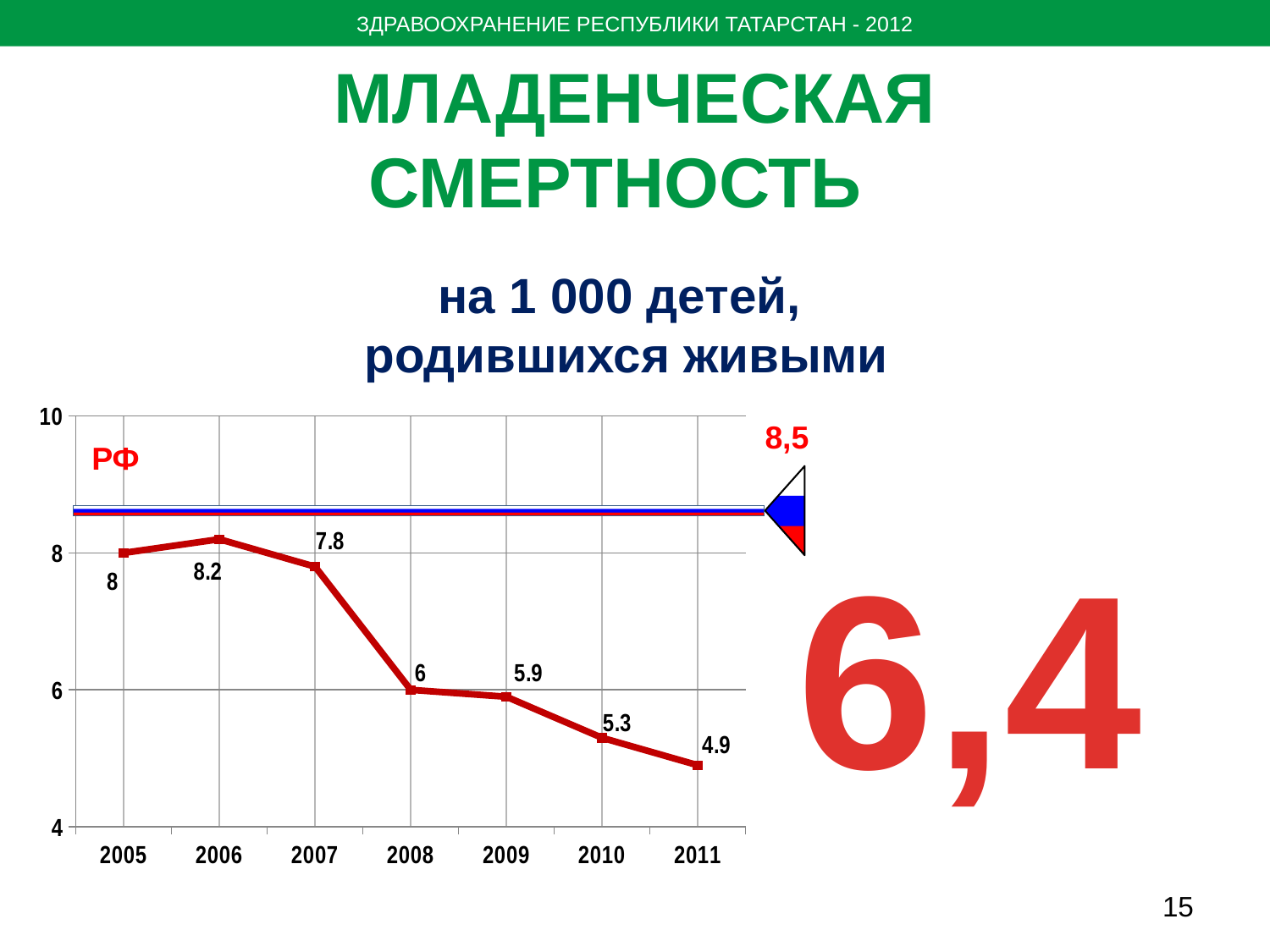
What kind of chart is shown on the slide? line chart What is the infant mortality value shown for 2007? 7.8 What value is labelled for the horizontal РФ reference line? 8,5 Do the plotted values generally rise or fall from 2006 to 2011? fall What is the value plotted for 2011? 4.9 What is the difference between the values for 2006 and 2011? 3.3 Which is larger, the value for 2008 or the value for 2009? 2008 What is the value plotted for 2005? 8 Which year has the lowest plotted value? 2011 Which year has the highest plotted value? 2006 Is the value for 2010 greater or less than 6? less How many years are shown on the x axis? 7